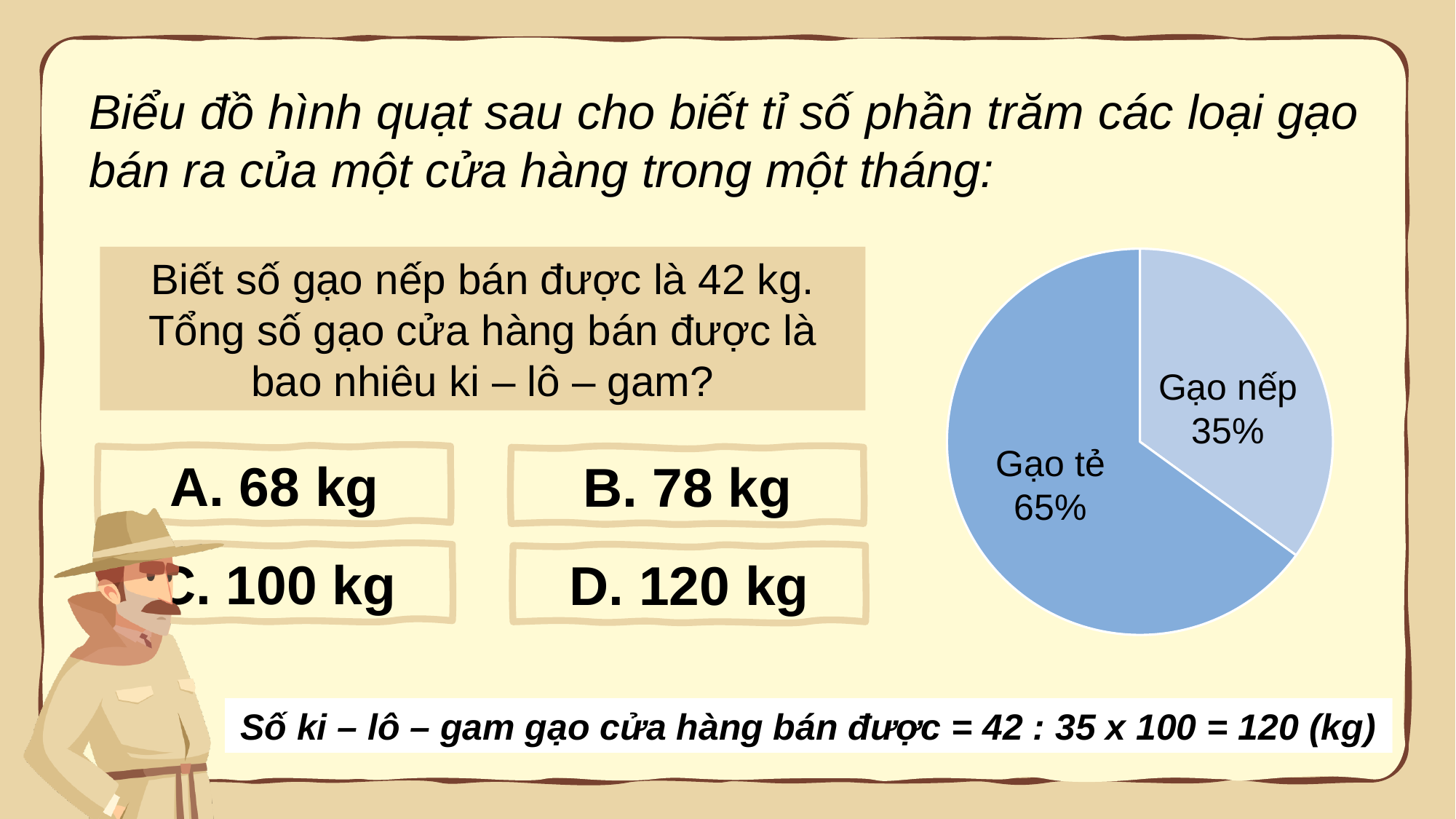
Is the share for Gạo tẻ greater or less than 50%? greater Which category has the smallest share of the pie chart? Gạo nếp Which is larger in the pie chart, Gạo nếp or Gạo tẻ? Gạo tẻ Which category has the largest share of the pie chart? Gạo tẻ What share of the pie does the Gạo nếp slice represent? 35% What do the two slices of the pie chart add up to? 100% What is the difference in percentage points between Gạo tẻ and Gạo nếp? 30% What percentage does the pie chart show for Gạo nếp? 35% How many slices does the pie chart have? 2 What colour is the Gạo tẻ slice compared with the Gạo nếp slice? darker blue What percentage does the pie chart show for Gạo tẻ? 65% What kind of chart is shown on the slide? pie chart